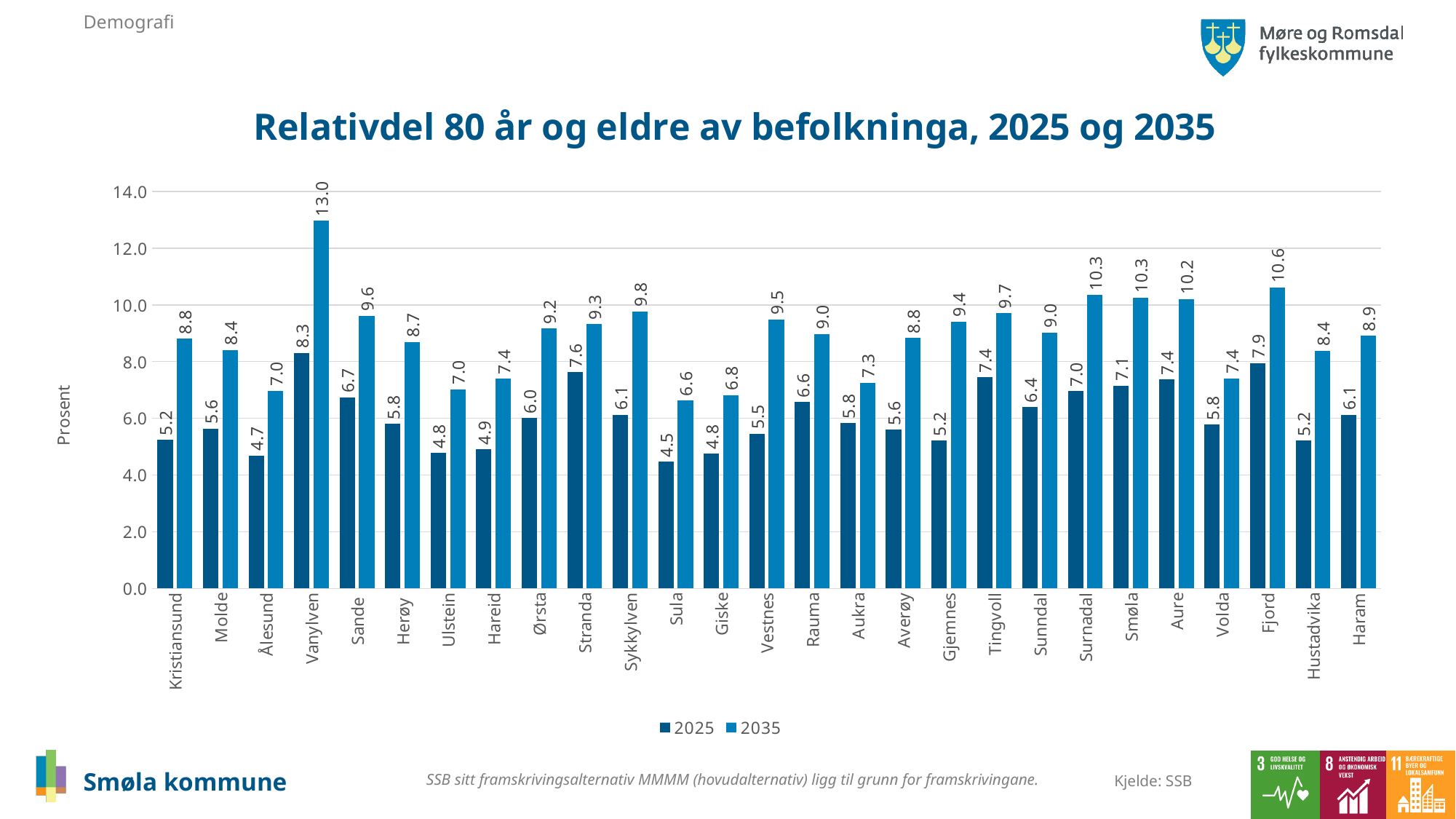
What is the value for Vanylven in 2025? 8.3 Is the 2035 value for Vanylven greater or less than 12.0? greater What is the label on the y axis? Prosent How many series does the legend list? 2 What kind of chart is shown on the slide? Bar chart What is the difference between the 2035 and 2025 values for Fjord? 2.7 How many municipalities are shown on the x axis? 27 What is the value for Smøla in 2035? 10.3 Which municipality has the highest value in 2035? Vanylven What is the title of the chart? Relativdel 80 år og eldre av befolkninga, 2025 og 2035 Which is larger: the 2035 value for Stranda or the 2035 value for Sykkylven? Sykkylven Which municipality has the lowest value in 2025? Sula